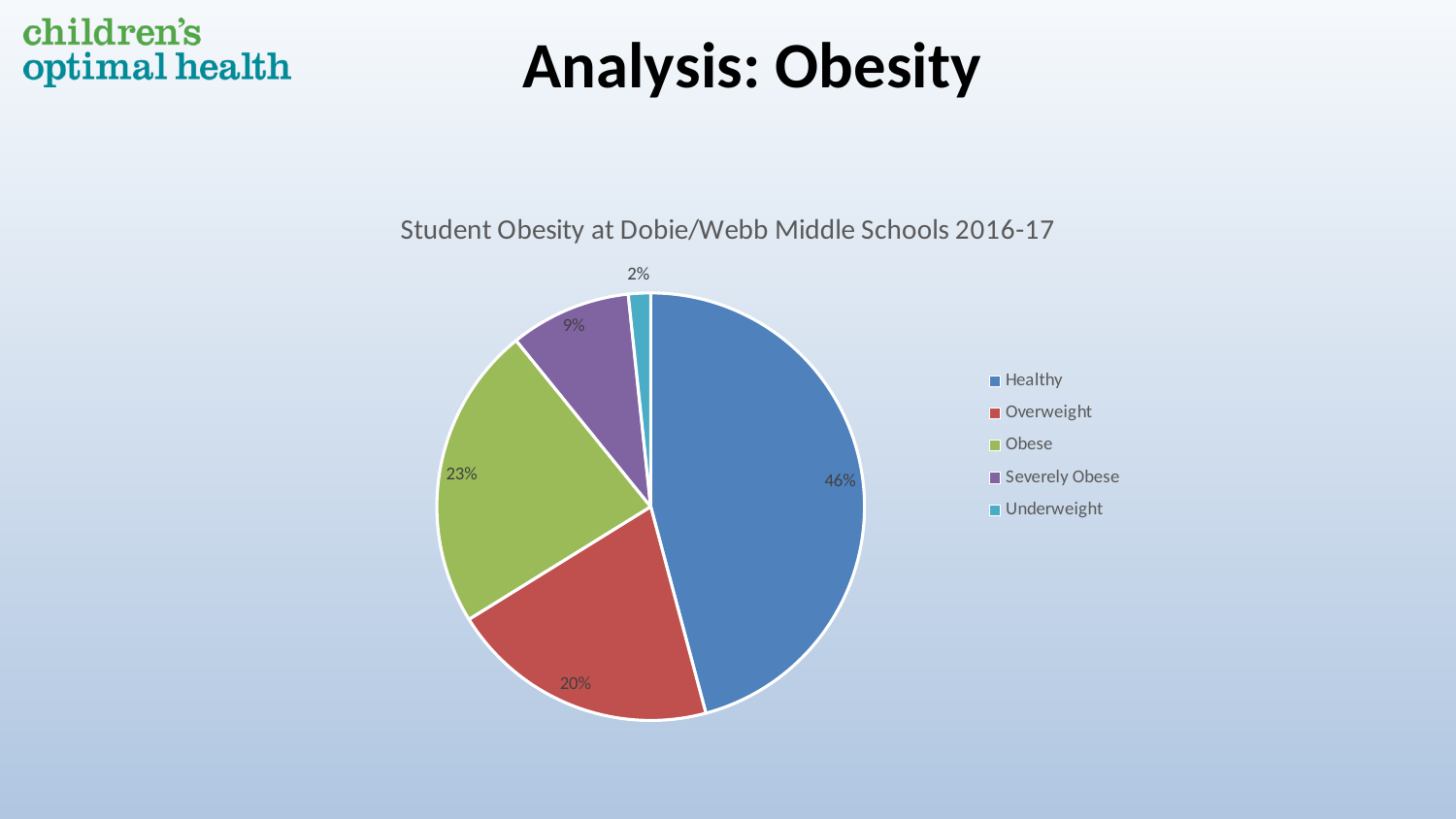
Which category has the smallest share of the pie? Underweight What percentage of students are Obese? 23% Which category has the largest share of the pie? Healthy Which is larger, the Obese share or the Overweight share? Obese What percentage of students are Underweight? 2% What kind of chart is shown on the slide? Pie chart What is the difference in percentage points between the Healthy and Obese shares? 23 What percentage of students are in the Healthy category? 46% How many categories does the legend list? 5 What percentage of students are Severely Obese? 9% What percentage of students are Overweight? 20% What is the title of the chart? Student Obesity at Dobie/Webb Middle Schools 2016-17